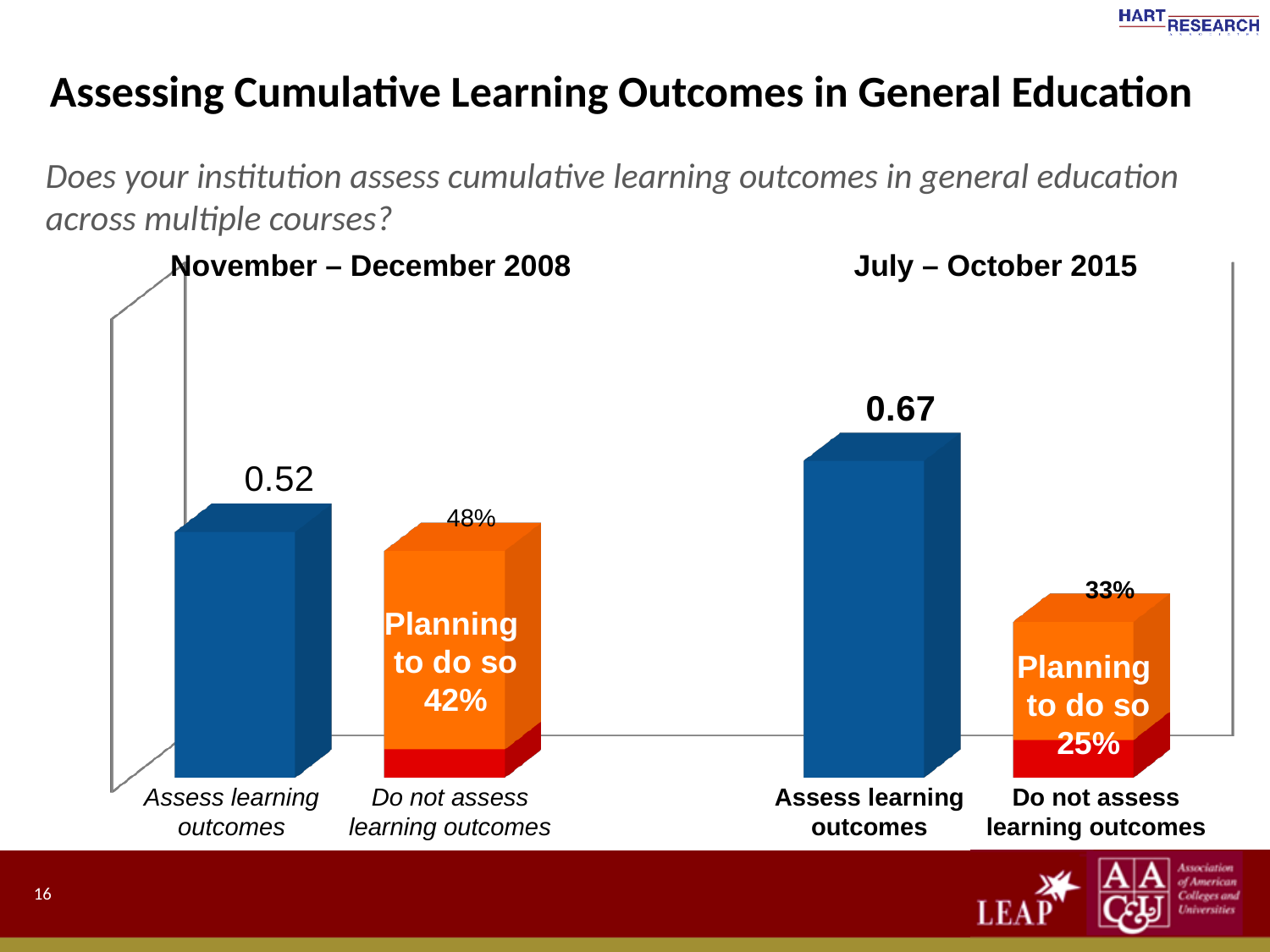
What kind of chart is shown on the slide? Bar chart Which bar is the shortest on the chart? Do not assess learning outcomes (July – October 2015) What is the value for "Assess learning outcomes" in the July – October 2015 group? 0.67 How many bars are shown on the chart in total? 4 In the July – October 2015 group, what share of institutions that do not assess learning outcomes are planning to do so? 25% What is the value for "Do not assess learning outcomes" in the November – December 2008 group? 48% Which is larger: the "Do not assess learning outcomes" value in 2008 or in 2015? 2008 What is the value for "Do not assess learning outcomes" in the July – October 2015 group? 33% What is the value for "Assess learning outcomes" in the November – December 2008 group? 0.52 In the November – December 2008 group, what share of institutions that do not assess learning outcomes are planning to do so? 42% Which bar is the tallest on the chart? Assess learning outcomes (July – October 2015) What is the difference between the "Do not assess learning outcomes" values for 2008 and 2015? 15%